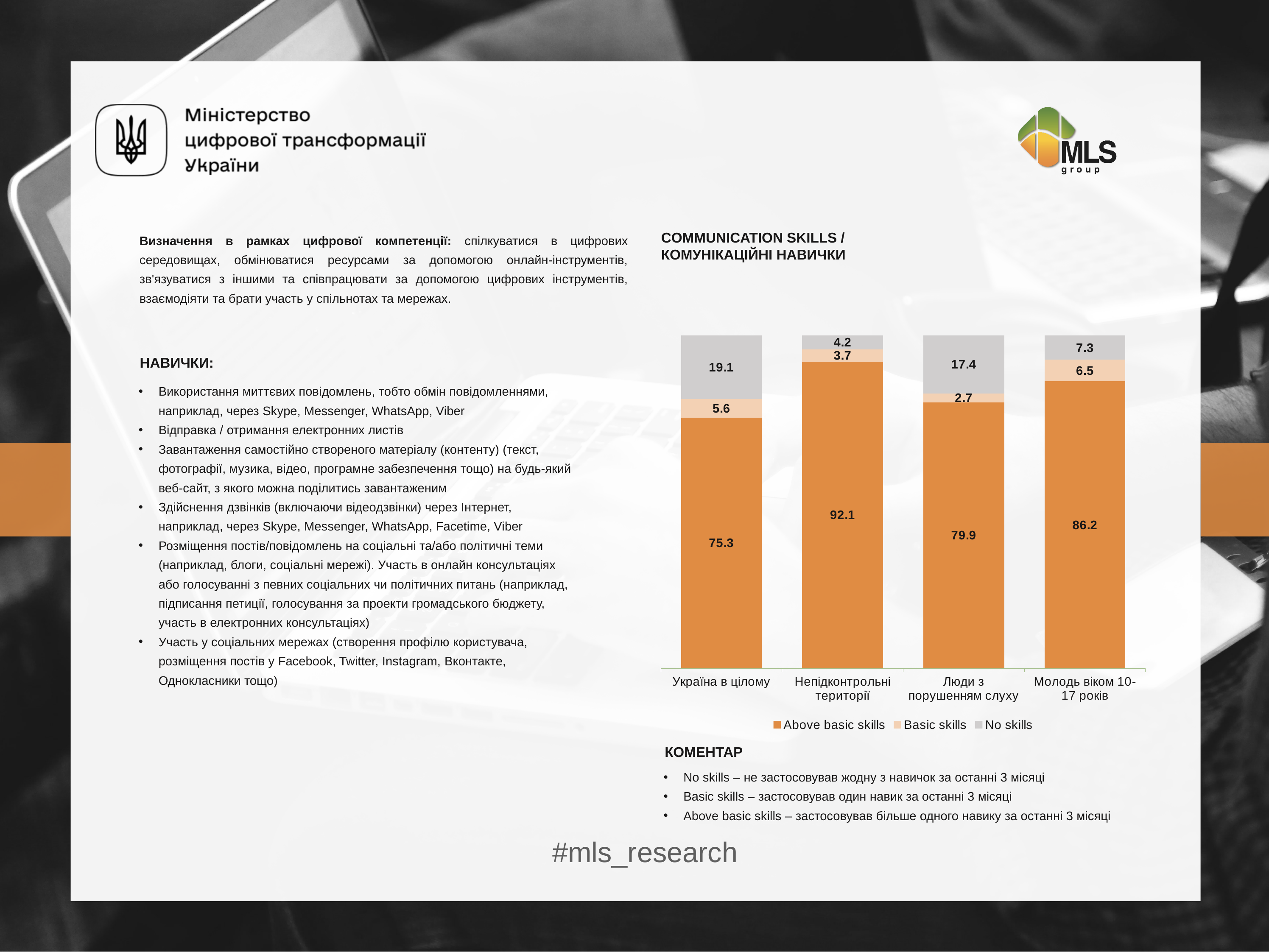
What is the difference between the "Above basic skills" values for Непідконтрольні території and Україна в цілому? 16.8 What is the value for "Above basic skills" for Україна в цілому? 75.3 What is the value for "No skills" for Люди з порушенням слуху? 17.4 How many series does the legend list? 3 What is the value for "Basic skills" for Молодь віком 10-17 років? 6.5 What kind of chart is shown on the slide? Stacked bar chart What is the title of the chart? COMMUNICATION SKILLS / КОМУНІКАЦІЙНІ НАВИЧКИ How many categories are shown on the x axis? 4 What is the total of the stacked bar for Люди з порушенням слуху? 100.0 Which category has the lowest value for "No skills"? Непідконтрольні території Which is larger: the "No skills" value for Україна в цілому or for Молодь віком 10-17 років? Україна в цілому Which category has the highest value for "Above basic skills"? Непідконтрольні території